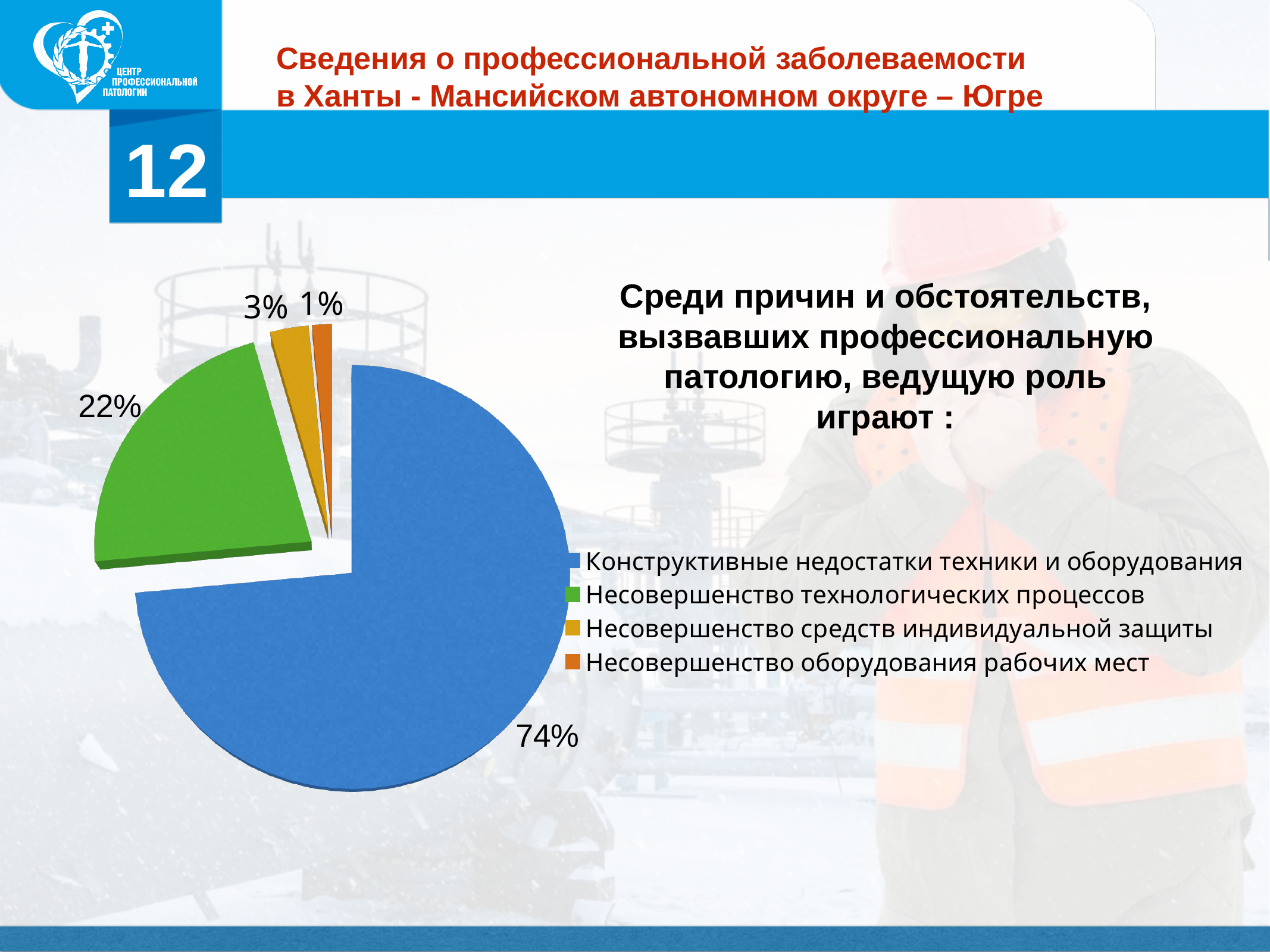
What colour is the slice for "Несовершенство оборудования рабочих мест"? Orange What kind of chart is shown on the slide? Pie chart What share of the pie does "Несовершенство средств индивидуальной защиты" have? 3% What share of the pie does "Несовершенство технологических процессов" have? 22% What share of the pie does "Несовершенство оборудования рабочих мест" have? 1% Which category has the smallest slice of the pie? Несовершенство оборудования рабочих мест Which category has the largest slice of the pie? Конструктивные недостатки техники и оборудования How many categories does the pie chart have? 4 What is the difference in percentage points between "Конструктивные недостатки техники и оборудования" and "Несовершенство технологических процессов"? 52 What colour is the slice for "Несовершенство технологических процессов"? Green Which is larger: the share for "Несовершенство технологических процессов" or for "Несовершенство средств индивидуальной защиты"? Несовершенство технологических процессов